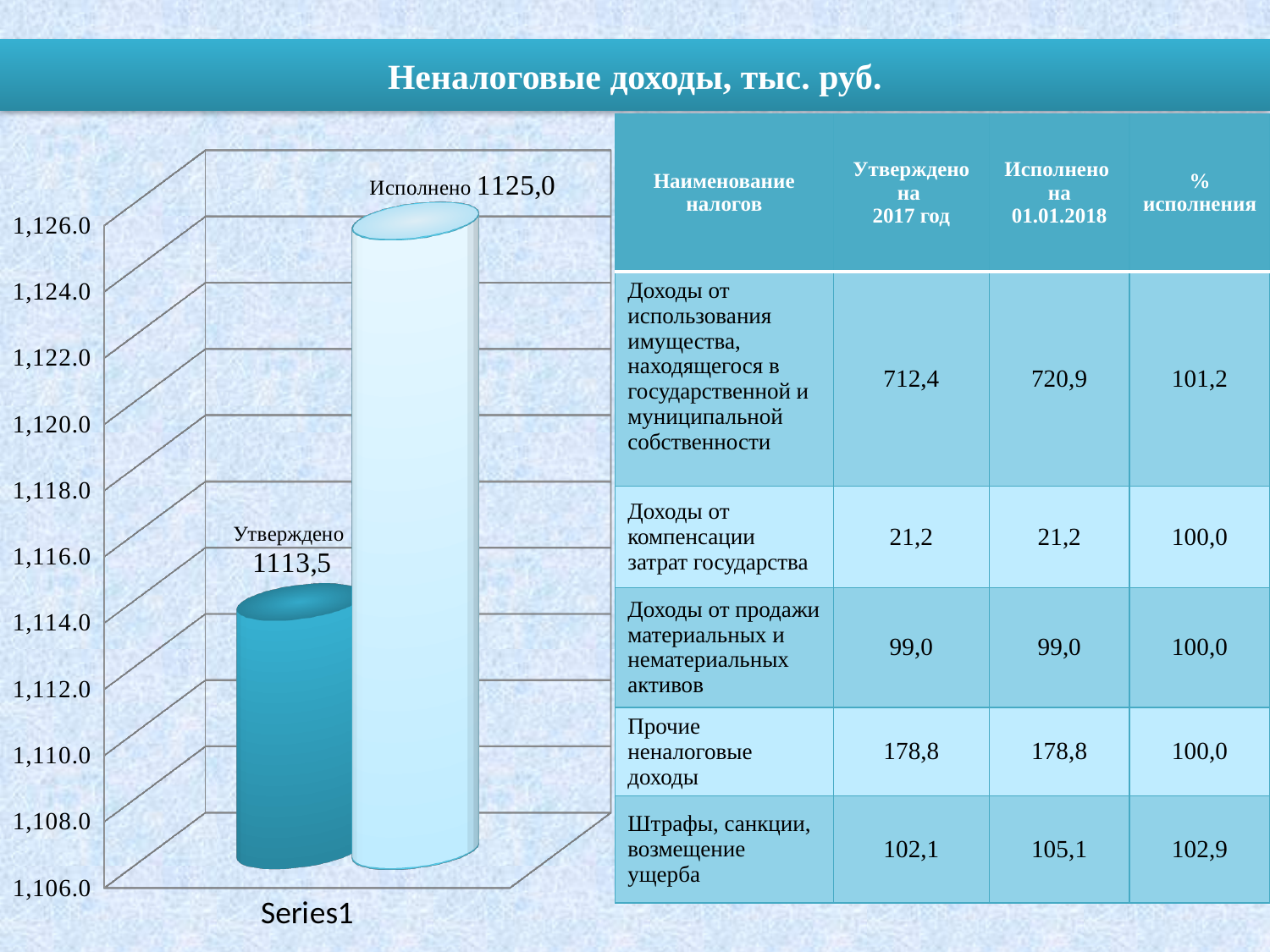
What kind of chart is shown on the slide? bar chart Which bar in the chart is the lowest? Утверждено Which is larger in the chart, Утверждено or Исполнено? Исполнено What label appears under the bars on the x axis of the chart? Series1 Which bar in the chart is the highest? Исполнено What is the value of the Исполнено bar in the chart? 1125,0 Is the value for Утверждено greater or less than 1,116.0? less What is the difference between the Исполнено and Утверждено values in the chart? 11,5 What is the value of the Утверждено bar in the chart? 1113,5 Is the value for Исполнено greater or less than 1,120.0? greater What is the title of the slide containing the chart? Неналоговые доходы, тыс. руб. How many bars are plotted in the chart? 2